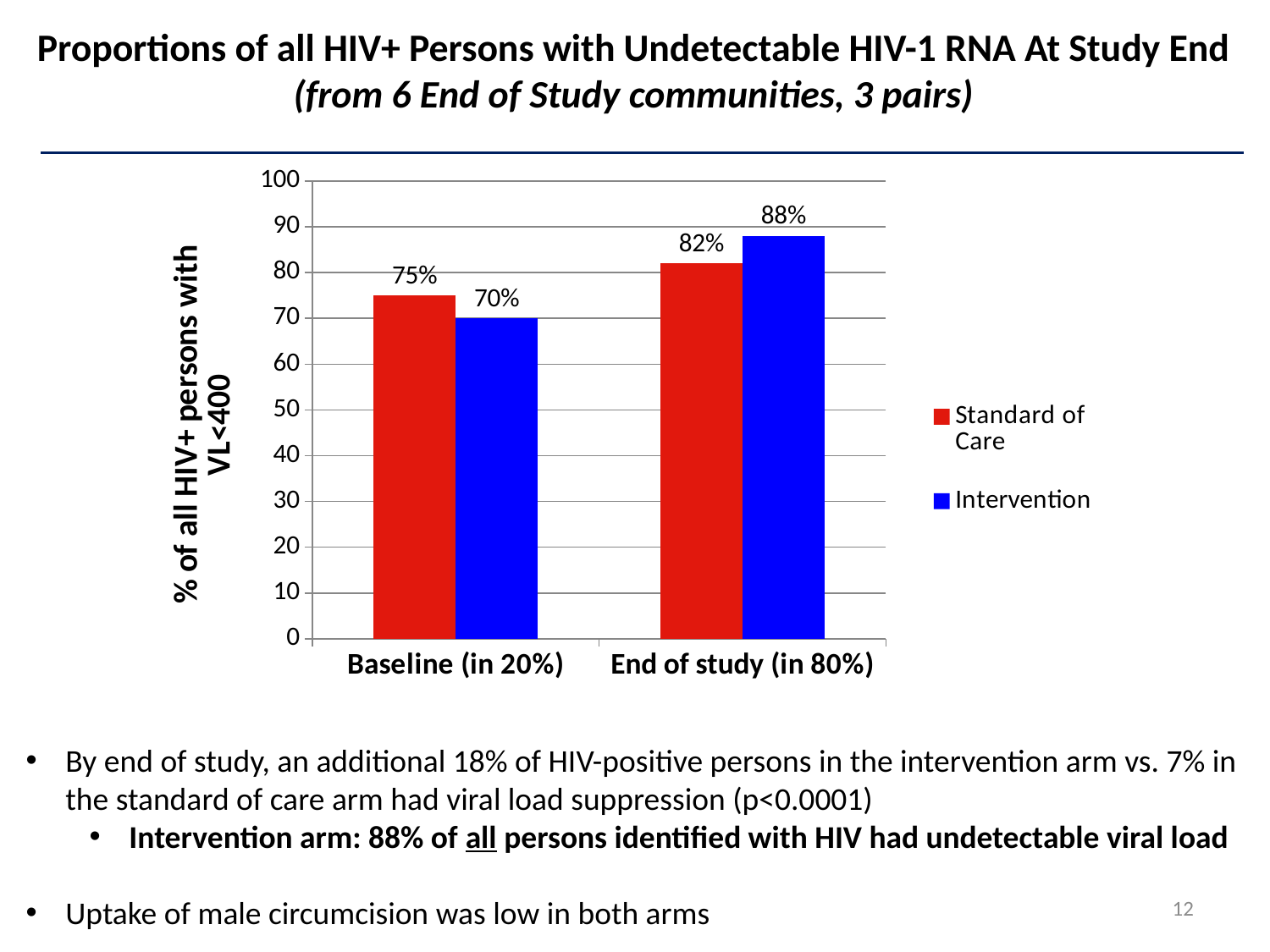
Which bar has the lowest value in the chart? Intervention at Baseline (in 20%) What is the value for Standard of Care at End of study (in 80%)? 82% How many series does the legend list? 2 What kind of chart is shown on the slide? Bar chart What is the difference between the Intervention values at End of study (in 80%) and Baseline (in 20%)? 18% What is the value for Intervention at Baseline (in 20%)? 70% At Baseline (in 20%), which is larger: Standard of Care or Intervention? Standard of Care What is the difference between the Intervention and Standard of Care values at End of study (in 80%)? 6% What is the value for Intervention at End of study (in 80%)? 88% What is the label of the y axis? % of all HIV+ persons with VL<400 What is the value for Standard of Care at Baseline (in 20%)? 75% Which series has the highest value at End of study (in 80%)? Intervention